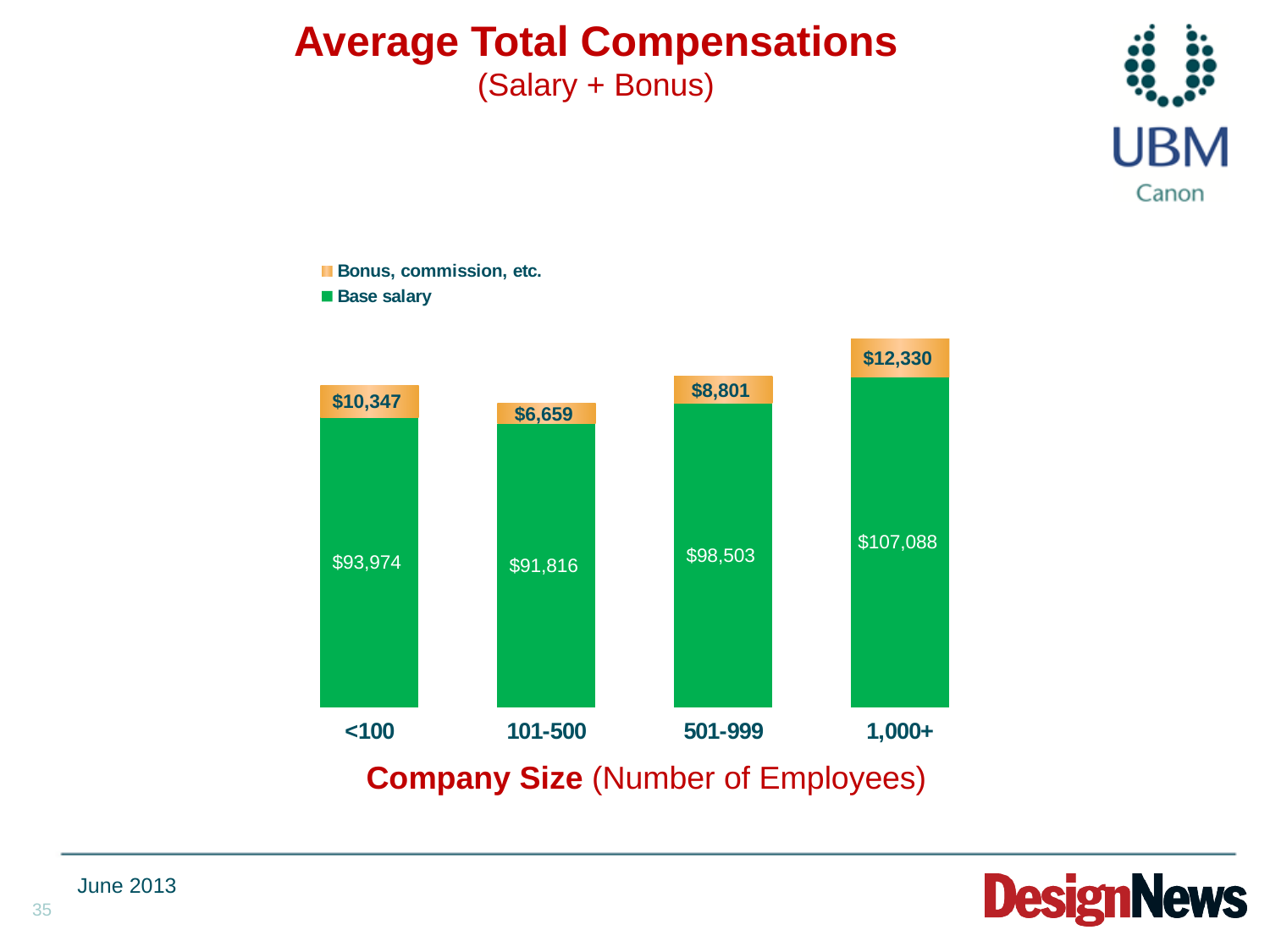
What is the base salary for companies with 1,000+ employees? $107,088 How many series does the legend list? 2 Which is larger, the bonus for the <100 company size or the bonus for the 501-999 company size? <100 What is the bonus, commission, etc. value for companies with 101-500 employees? $6,659 How many company size categories are shown on the x axis? 4 What is the difference in base salary between the 1,000+ and <100 company sizes? $13,114 Which company size has the lowest bonus, commission, etc. value? 101-500 What kind of chart is shown on the slide? Stacked bar chart Which company size has the highest base salary? 1,000+ What is the base salary for companies with fewer than 100 employees (<100)? $93,974 Which colour represents base salary in the chart? Green What is the total compensation (base salary plus bonus) for the 1,000+ company size? $119,418